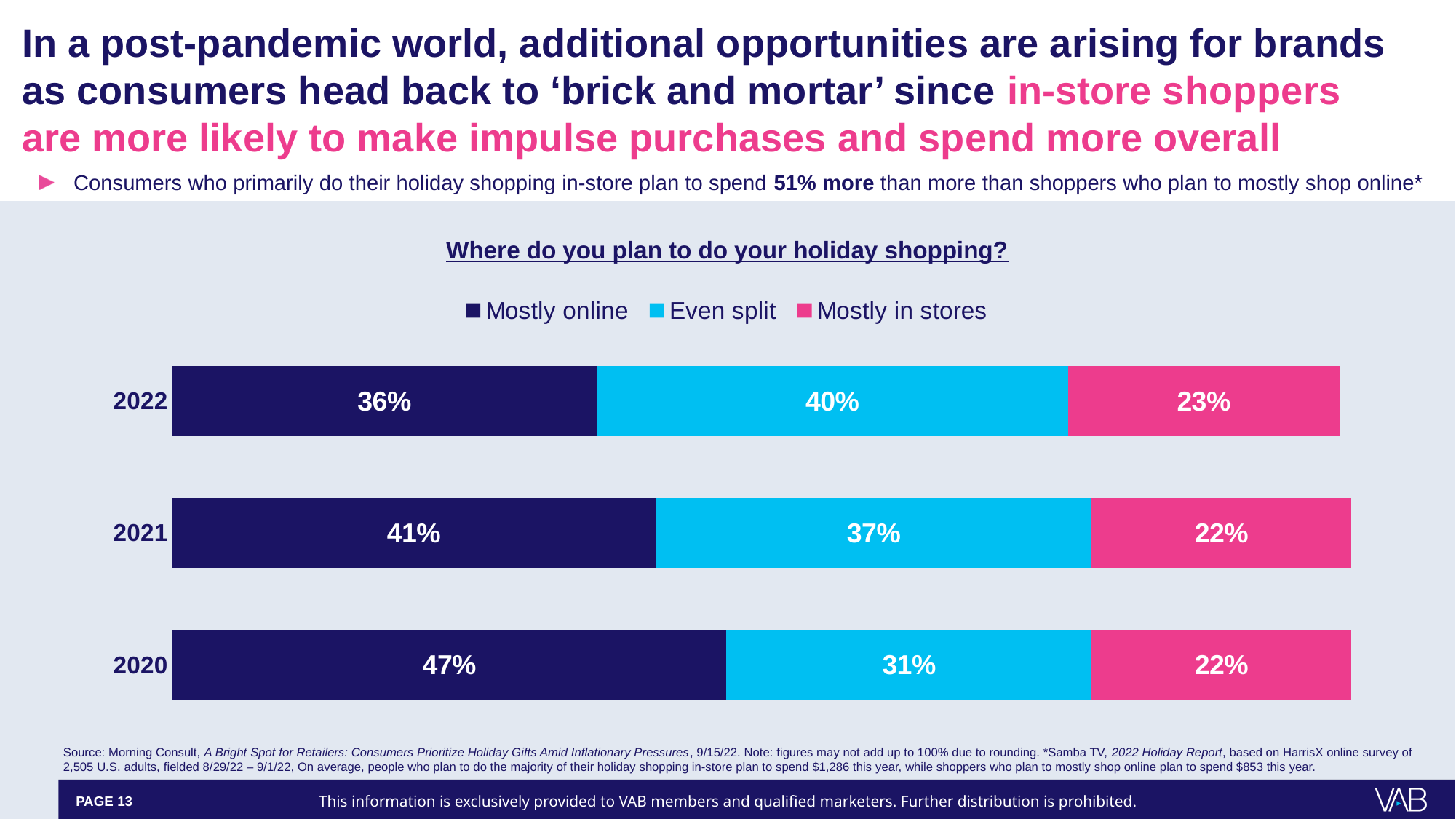
What is the title of the chart? Where do you plan to do your holiday shopping? What percentage planned to shop mostly in stores in 2021? 22% Which year has the highest 'Mostly online' share? 2020 In 2022, which is larger: the 'Mostly online' share or the 'Even split' share? Even split What kind of chart is shown on the slide? Stacked bar chart What percentage of consumers planned to do their holiday shopping mostly online in 2022? 36% What is the difference between the 'Mostly online' share in 2020 and in 2022? 11 percentage points What is the 'Even split' value for 2020? 31% Which year has the lowest 'Even split' share? 2020 How does the 'Mostly online' share change from 2020 to 2022? It falls How many years are shown on the chart? 3 How many series does the legend list? 3